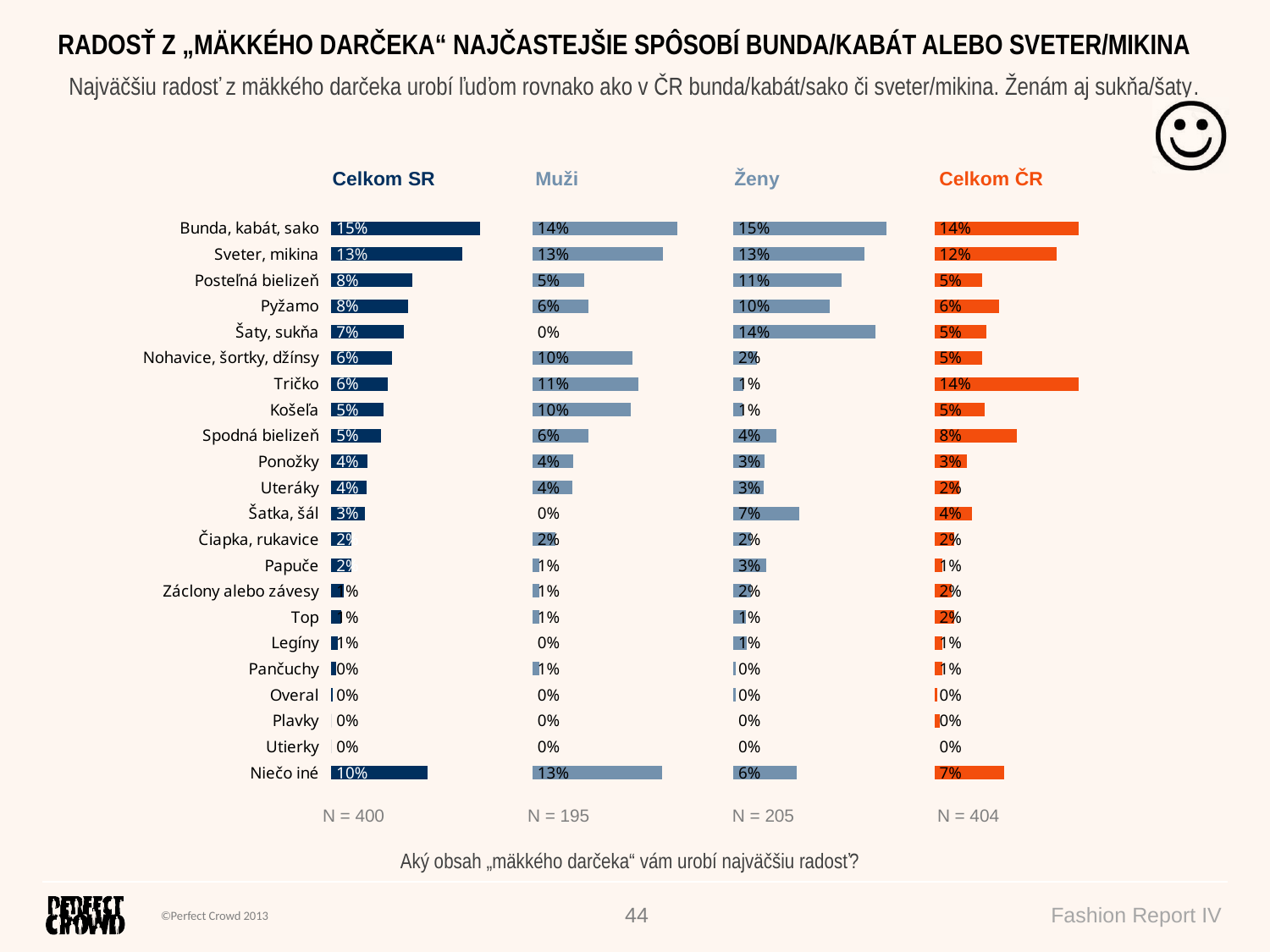
In the Celkom ČR chart, which is larger: the value for Tričko or the value for Košeľa? Tričko In the Celkom SR chart, what is the value for Niečo iné? 10% What is the sample size (N) shown under the Celkom ČR chart? N = 404 In the Celkom SR chart, what is the value for Posteľná bielizeň? 8% How many categories are listed in the Celkom SR chart? 22 In the Muži chart, what is the value for Nohavice, šortky, džínsy? 10% In the Celkom ČR chart, what is the value for Spodná bielizeň? 8% In the Muži chart, which is larger: the value for Tričko or the value for Spodná bielizeň? Tričko In the Celkom SR chart, which category has the highest value? Bunda, kabát, sako What kind of chart is the Muži chart? Bar chart In the Ženy chart, what is the difference between the values for Šaty, sukňa and Nohavice, šortky, džínsy? 12 percentage points In the Ženy chart, what is the value for Šaty, sukňa? 14%